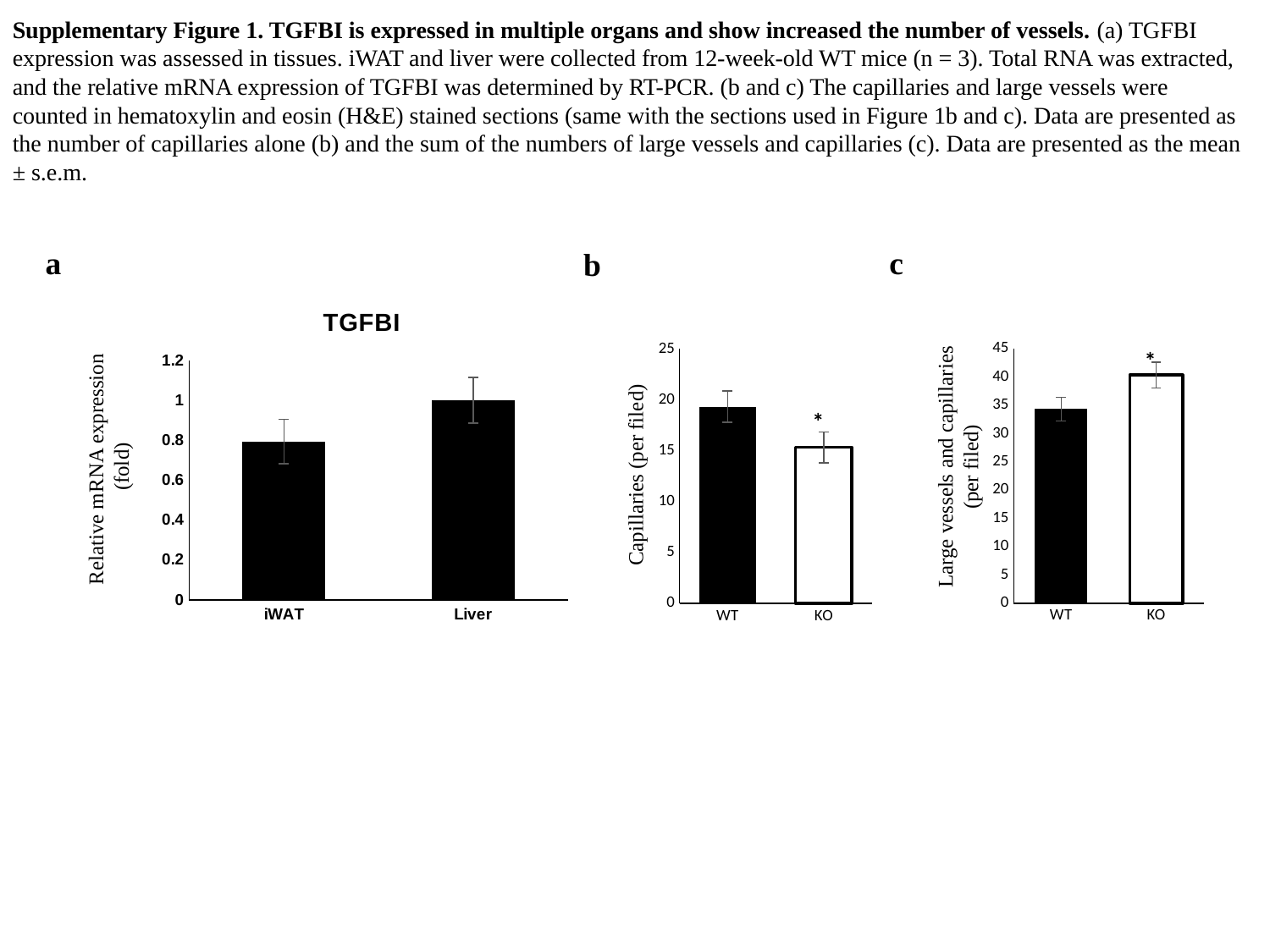
In chart a (TGFBI), is the value for iWAT greater or less than 0.6? greater In chart a (TGFBI), what kind of chart is shown? bar chart In chart c, what is the label on the y axis? Large vessels and capillaries (per filed) In chart b (Capillaries), is the value for WT greater or less than 15? greater In chart b (Capillaries), which group has the lower number of capillaries per field? KO In chart c (Large vessels and capillaries), is the value for WT greater or less than 30? greater In chart a (TGFBI), how many categories are shown on the x axis? 2 In chart a (TGFBI), what is the relative mRNA expression value for Liver? 1 In chart c (Large vessels and capillaries), which group has the higher value, WT or KO? KO In chart a, what is the title of the chart? TGFBI In chart a (TGFBI), which category has the higher relative mRNA expression? Liver